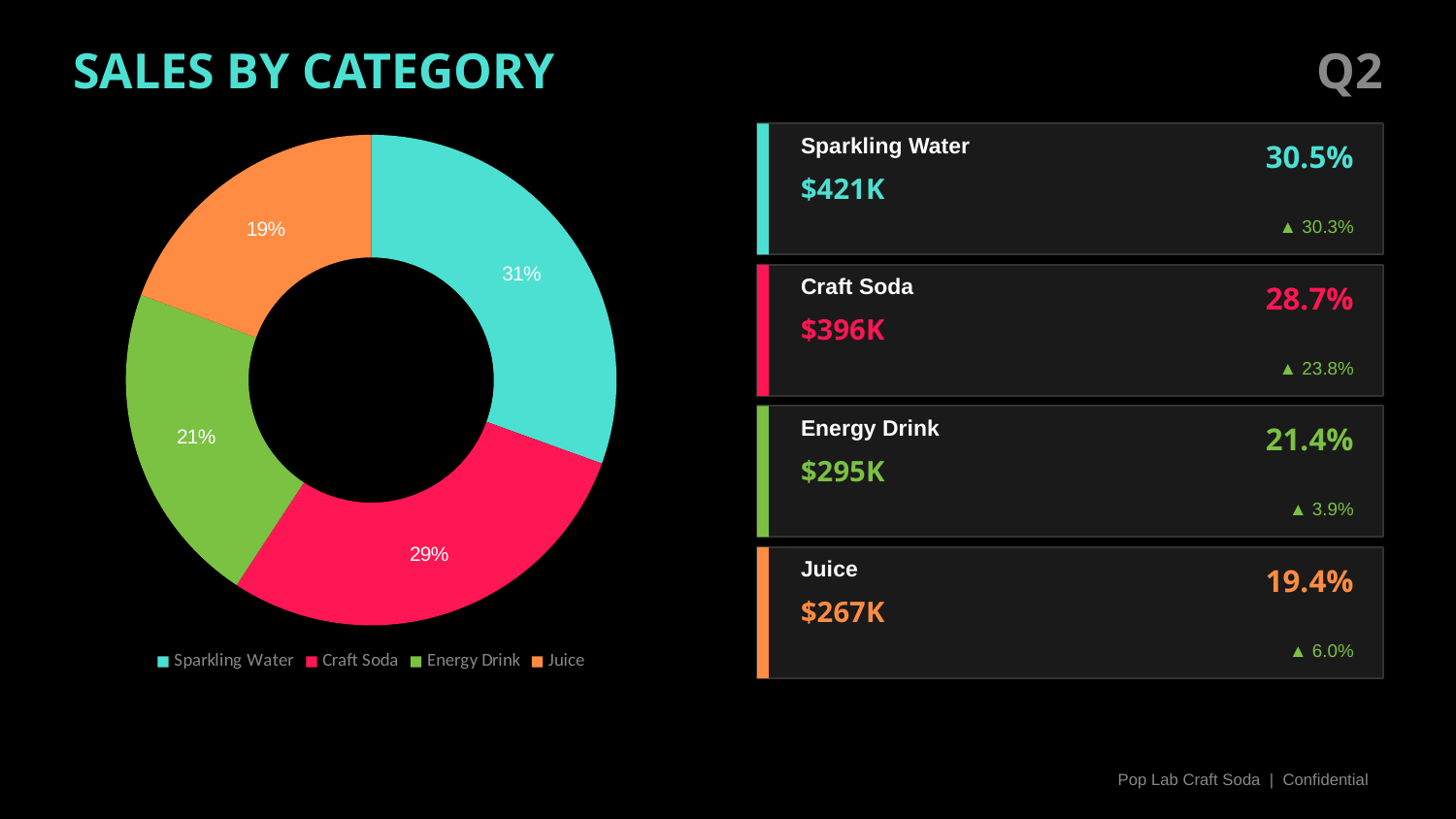
What percentage share does the Juice slice show in the donut chart? 19% What is the difference in percentage points between the Sparkling Water slice and the Juice slice in the donut chart? 12 How many categories are shown in the donut chart? 4 What percentage share does the Energy Drink slice show in the donut chart? 21% What colour is the Energy Drink slice in the donut chart? Green Which slice is larger in the donut chart, Craft Soda or Energy Drink? Craft Soda Which category has the smallest slice in the donut chart? Juice Which category has the largest slice in the donut chart? Sparkling Water What percentage share does the Sparkling Water slice show in the donut chart? 31% How many entries does the legend of the donut chart list? 4 What percentage share does the Craft Soda slice show in the donut chart? 29% What kind of chart is shown on the slide? Donut chart